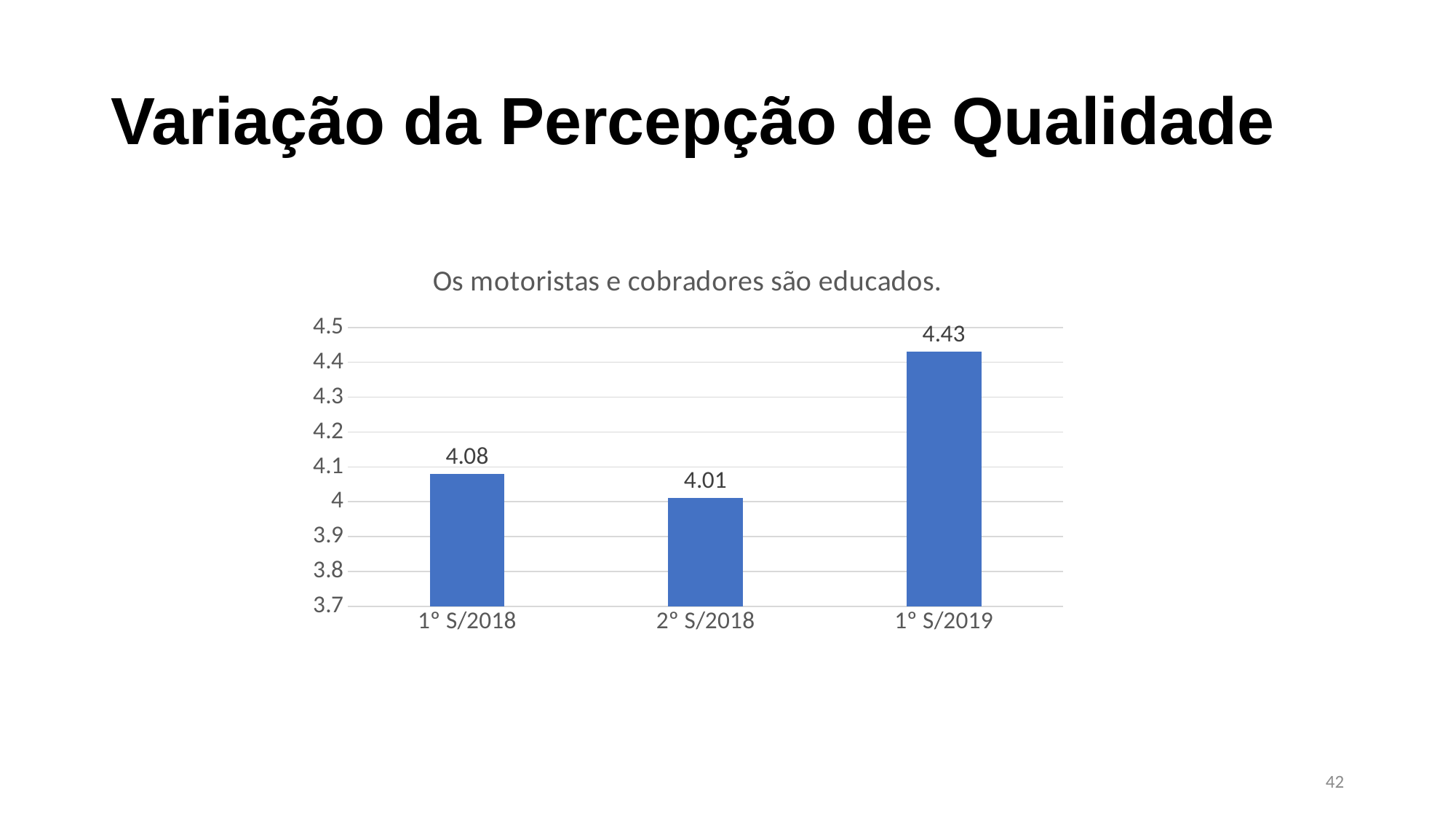
What kind of chart is shown on the slide? bar chart Which category has the highest value? 1° S/2019 What is the value for 1° S/2019? 4.43 What is the difference between the values for 1° S/2019 and 2° S/2018? 0.42 How many categories are shown on the x axis? 3 Is the value for 1° S/2019 greater or less than 4.4? greater Which is larger, the value for 1° S/2018 or the value for 1° S/2019? 1° S/2019 Which category has the lowest value? 2° S/2018 What is the value for 1° S/2018? 4.08 What is the value for 2° S/2018? 4.01 What is the title of the chart? Os motoristas e cobradores são educados. What is the difference between the values for 1° S/2018 and 2° S/2018? 0.07